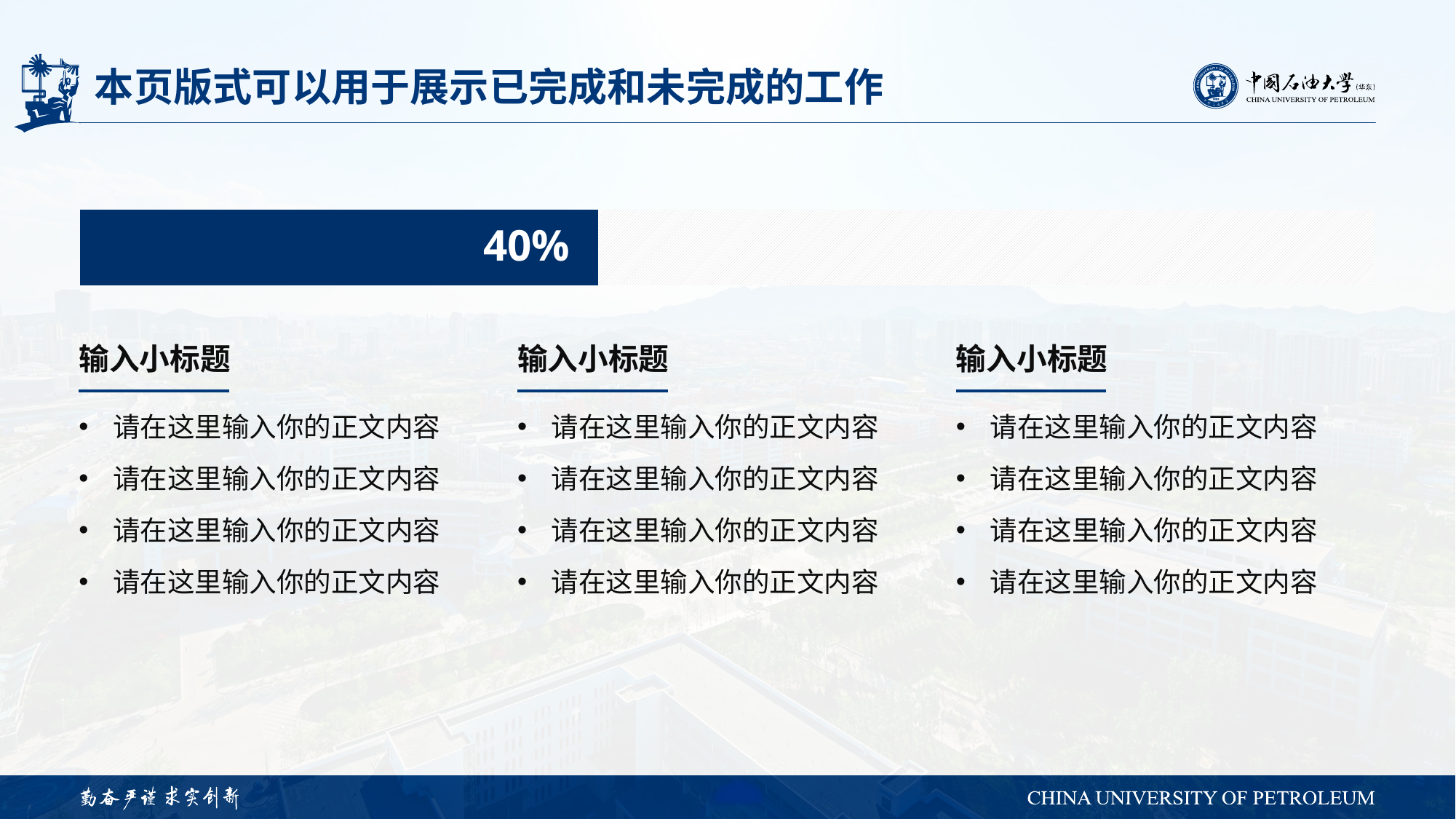
How many bars are shown in the progress chart? 1 What colour is the filled (completed) portion of the progress bar? dark blue What percentage value is printed on the progress bar? 40% What kind of chart is used to show the completion progress on the slide? bar chart Is the completed portion shown on the progress bar greater or less than 50%? less What share of the progress bar remains unfilled, given the filled portion is labelled 40%? 60%